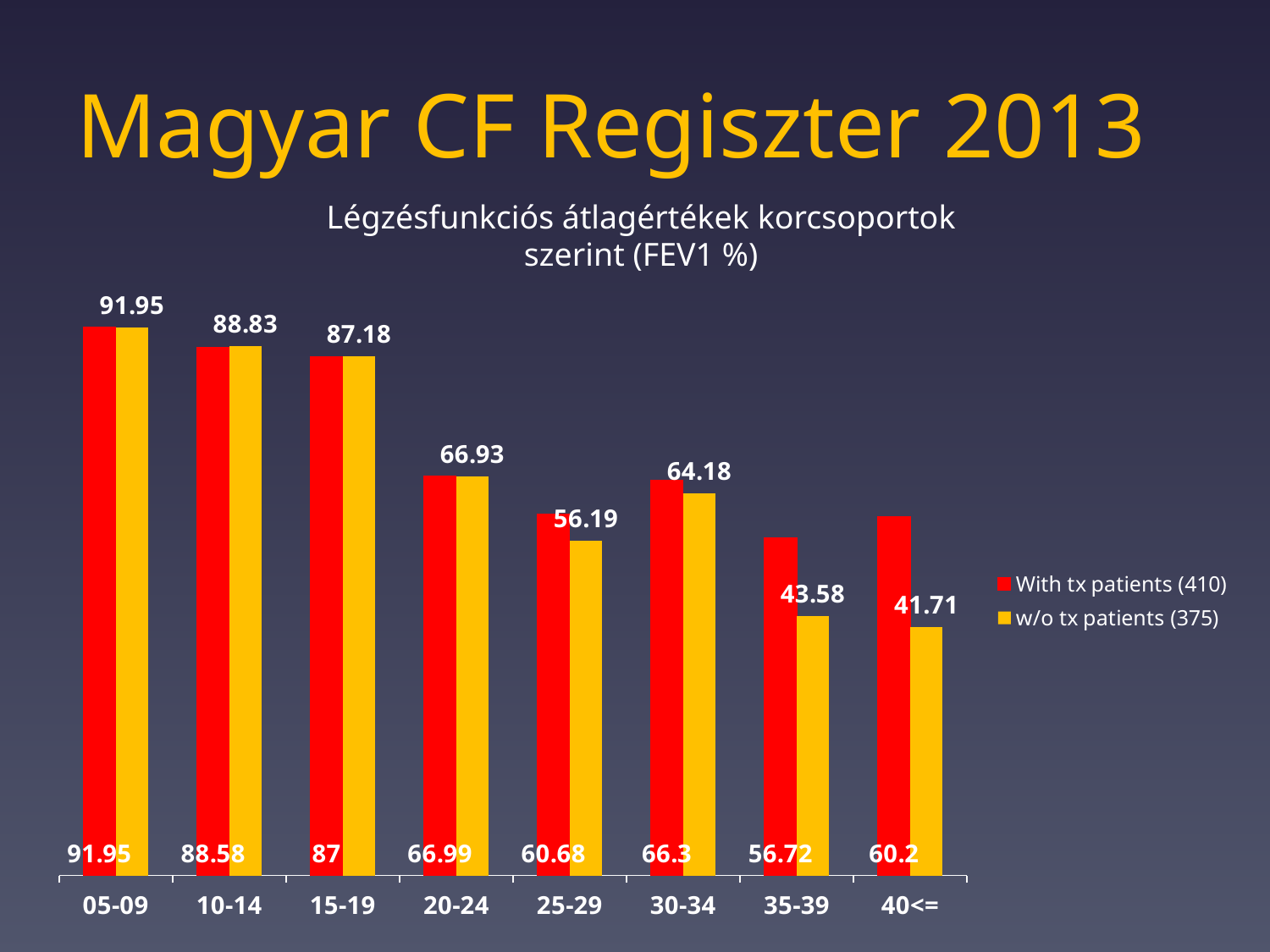
How many series does the legend list? 2 Which age group has the highest value for w/o tx patients? 05-09 How many age groups are shown on the x axis? 8 In the 30-34 age group, which series has the larger value, With tx patients or w/o tx patients? With tx patients What is the value for w/o tx patients in the 25-29 age group? 56.19 Which age group has the lowest value for With tx patients? 35-39 What is the value for w/o tx patients in the 35-39 age group? 43.58 What is the value for With tx patients in the 15-19 age group? 87 What kind of chart is shown on the slide? Bar chart Which age group has the lowest value for w/o tx patients? 40<= What is the difference between the With tx and w/o tx values in the 40<= age group? 18.49 What is the value for With tx patients in the 40<= age group? 60.2